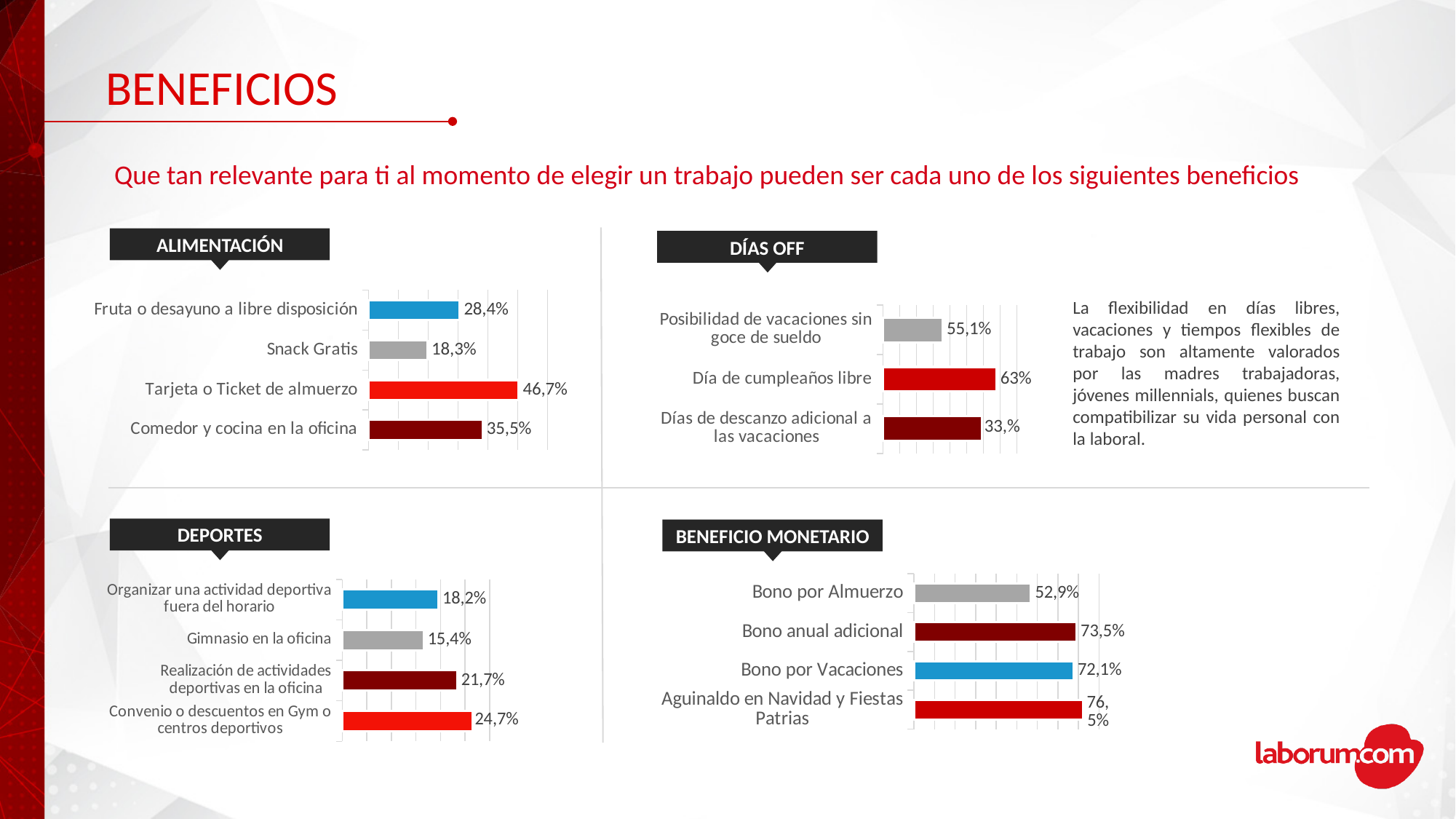
In the DEPORTES chart, which category has the highest value? Convenio o descuentos en Gym o centros deportivos In the BENEFICIO MONETARIO chart, which category has the lowest value? Bono por Almuerzo In the DEPORTES chart, which is larger: Organizar una actividad deportiva fuera del horario or Realización de actividades deportivas en la oficina? Realización de actividades deportivas en la oficina In the DÍAS OFF chart, what is the value for Día de cumpleaños libre? 63% In the ALIMENTACIÓN chart, what is the value for Tarjeta o Ticket de almuerzo? 46,7% In the DÍAS OFF chart, which category has the highest value? Día de cumpleaños libre How many categories are shown in the DÍAS OFF chart? 3 In the ALIMENTACIÓN chart, which category has the lowest value? Snack Gratis In the BENEFICIO MONETARIO chart, what is the value for Bono anual adicional? 73,5% In the DEPORTES chart, what is the value for Gimnasio en la oficina? 15,4% What type of chart is the ALIMENTACIÓN chart? Bar chart In the ALIMENTACIÓN chart, what is the difference between Tarjeta o Ticket de almuerzo and Comedor y cocina en la oficina? 11,2%